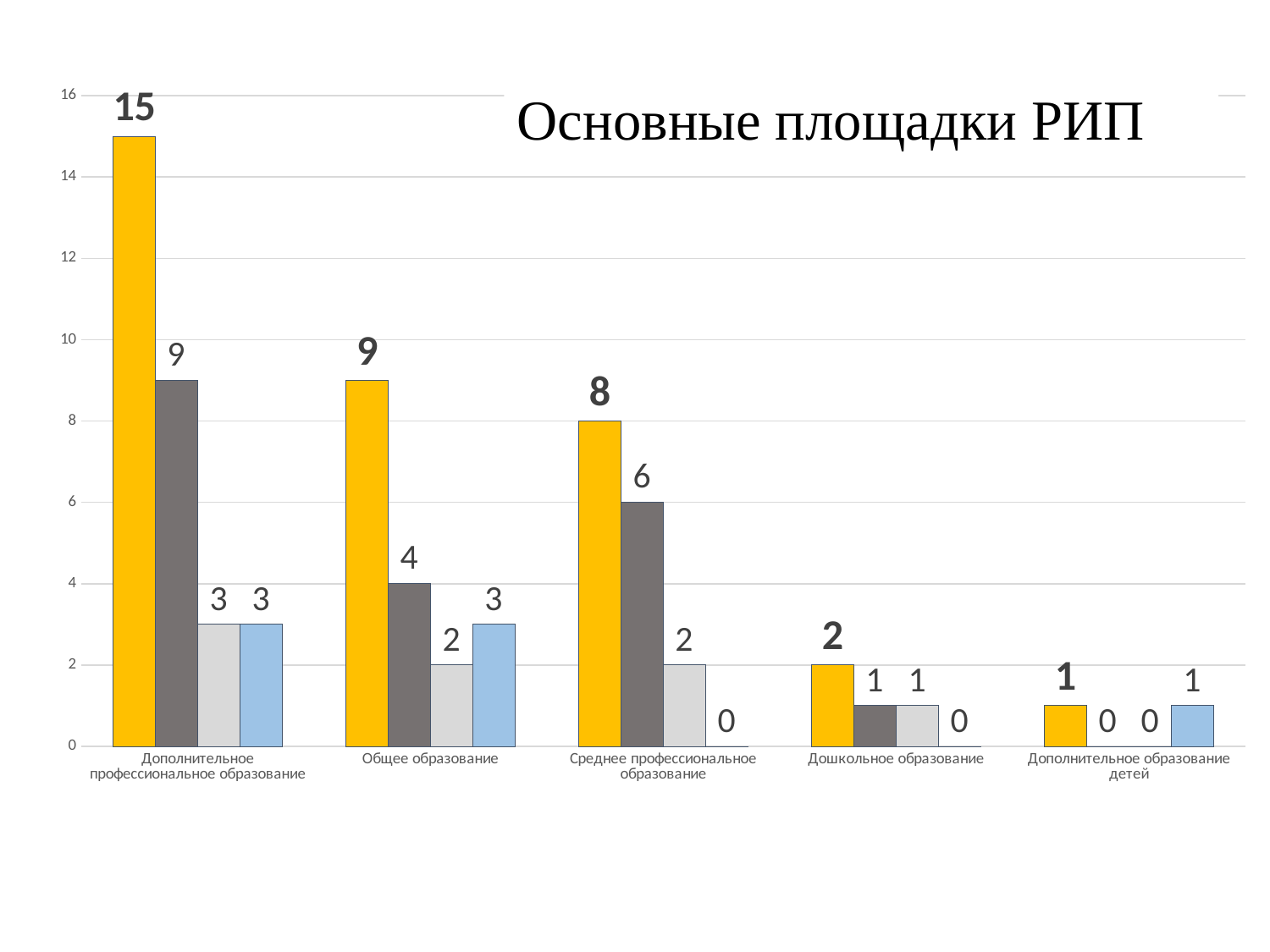
Which category has the lowest yellow bar? Дополнительное образование детей What is the value of the yellow bar for Дополнительное профессиональное образование? 15 Which is larger for Общее образование: the dark grey bar or the blue bar? the dark grey bar What is the value of the dark grey bar for Среднее профессиональное образование? 6 What kind of chart is shown on the slide? bar chart How many categories are shown on the x axis? 5 What is the value of the blue bar for Общее образование? 3 What is the difference between the yellow bar and the dark grey bar for Дополнительное профессиональное образование? 6 Which category has the highest yellow bar? Дополнительное профессиональное образование What is the title of the chart? Основные площадки РИП Do the yellow bars rise or fall from left to right across the categories? fall How many bars are shown for each category? 4